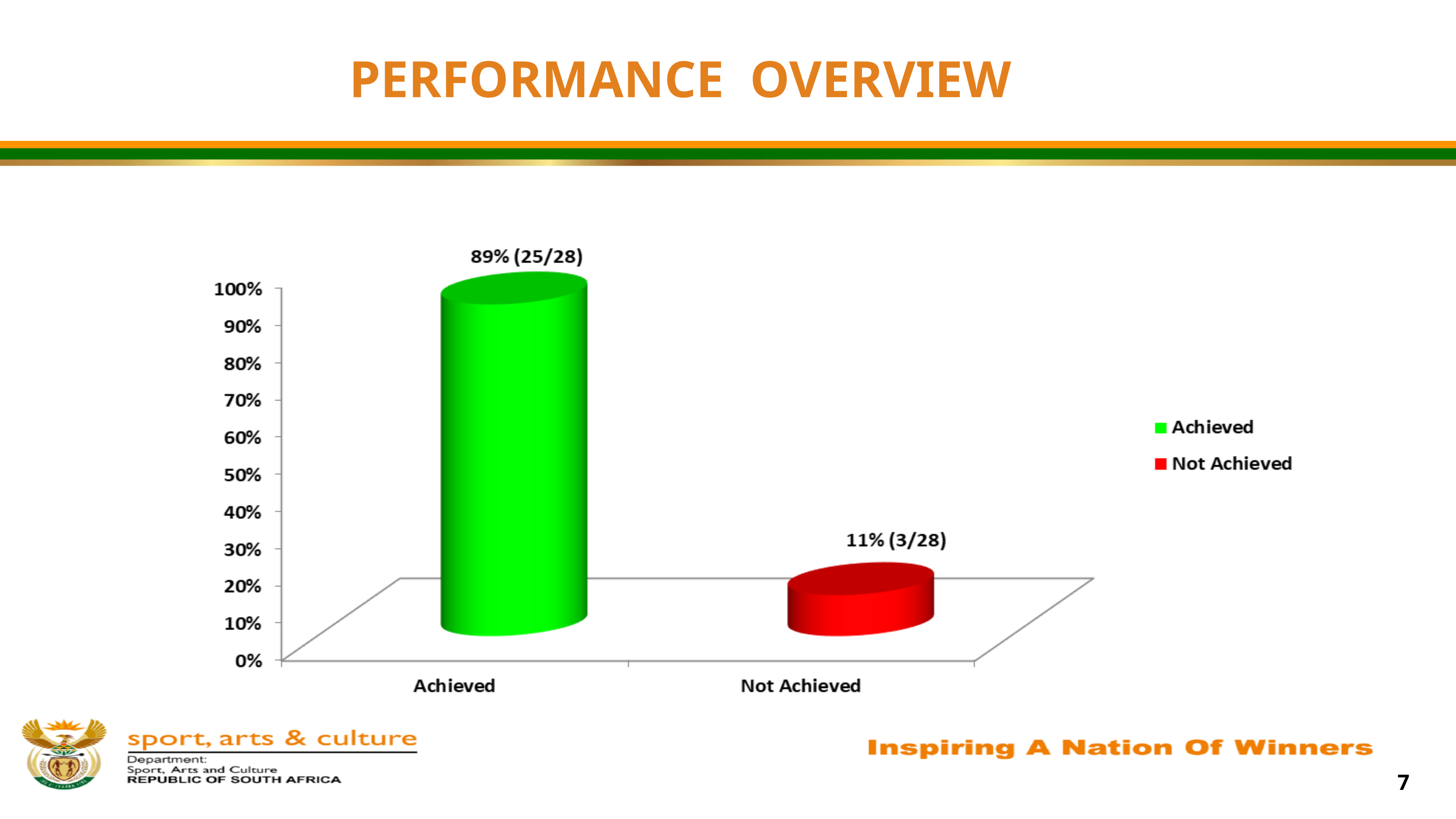
What percentage is shown for Achieved? 89% Which category has the highest value? Achieved How many entries does the legend list? 2 How many targets out of 28 were not achieved, according to the data label? 3 What colour is the bar for Not Achieved? Red What is the difference in percentage points between Achieved and Not Achieved? 78 How many categories are shown on the x axis? 2 What percentage is shown for Not Achieved? 11% What kind of chart is shown on the slide? Bar chart How many targets out of 28 were achieved, according to the data label? 25 Which is larger, the value for Achieved or the value for Not Achieved? Achieved Which category has the lowest value? Not Achieved